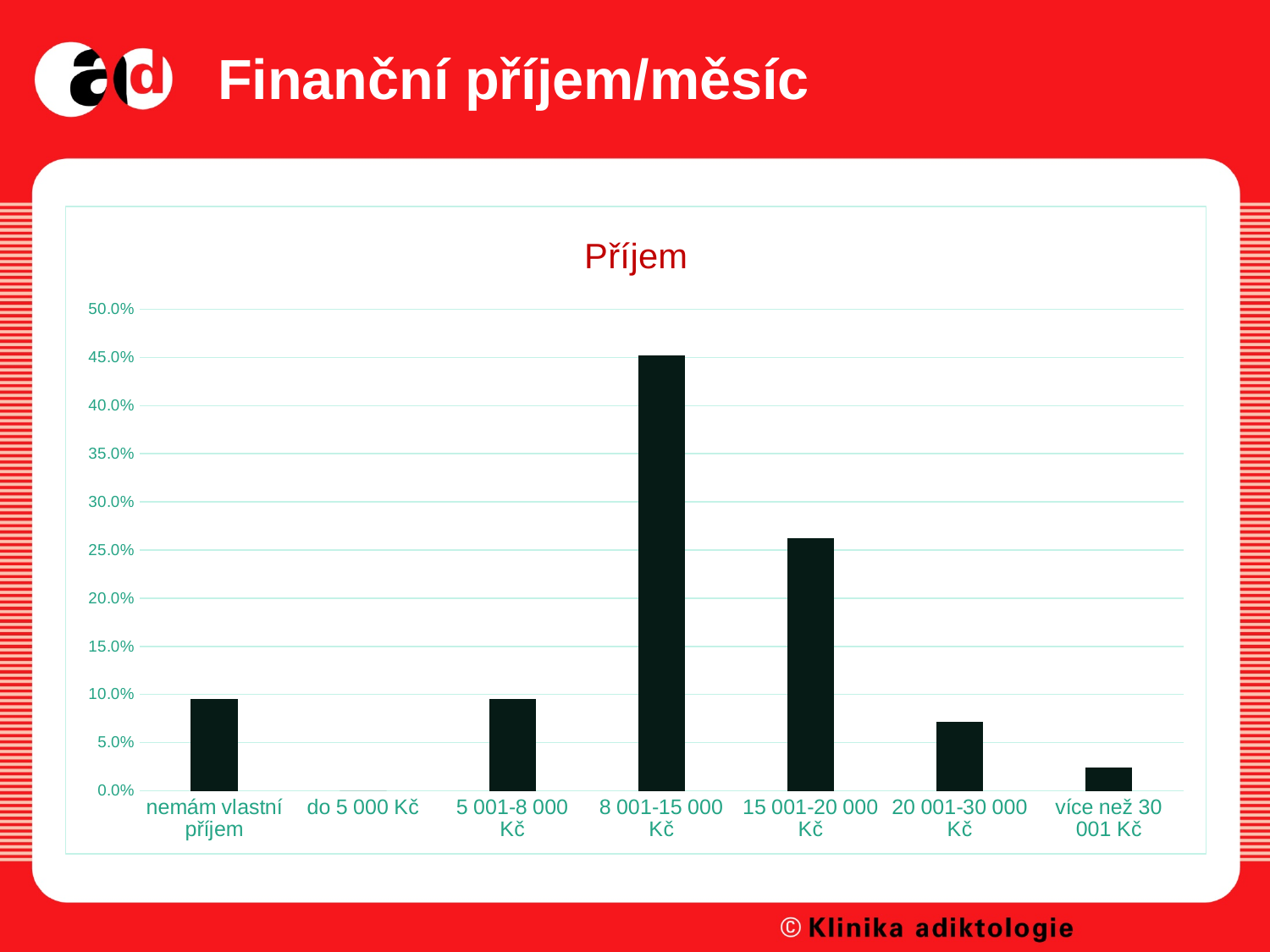
Is the value for 20 001-30 000 Kč greater or less than 10.0%? less Is the value for více než 30 001 Kč greater or less than 5.0%? less What is the title of the chart? Příjem What kind of chart is shown on the slide? bar chart Which is larger, the value for 8 001-15 000 Kč or the value for 5 001-8 000 Kč? 8 001-15 000 Kč Which income category has the lowest value? do 5 000 Kč Is the value for 8 001-15 000 Kč greater or less than 40.0%? greater How many income categories are shown on the x axis? 7 Which income category has the highest value? 8 001-15 000 Kč Which is larger, the value for 15 001-20 000 Kč or the value for 20 001-30 000 Kč? 15 001-20 000 Kč